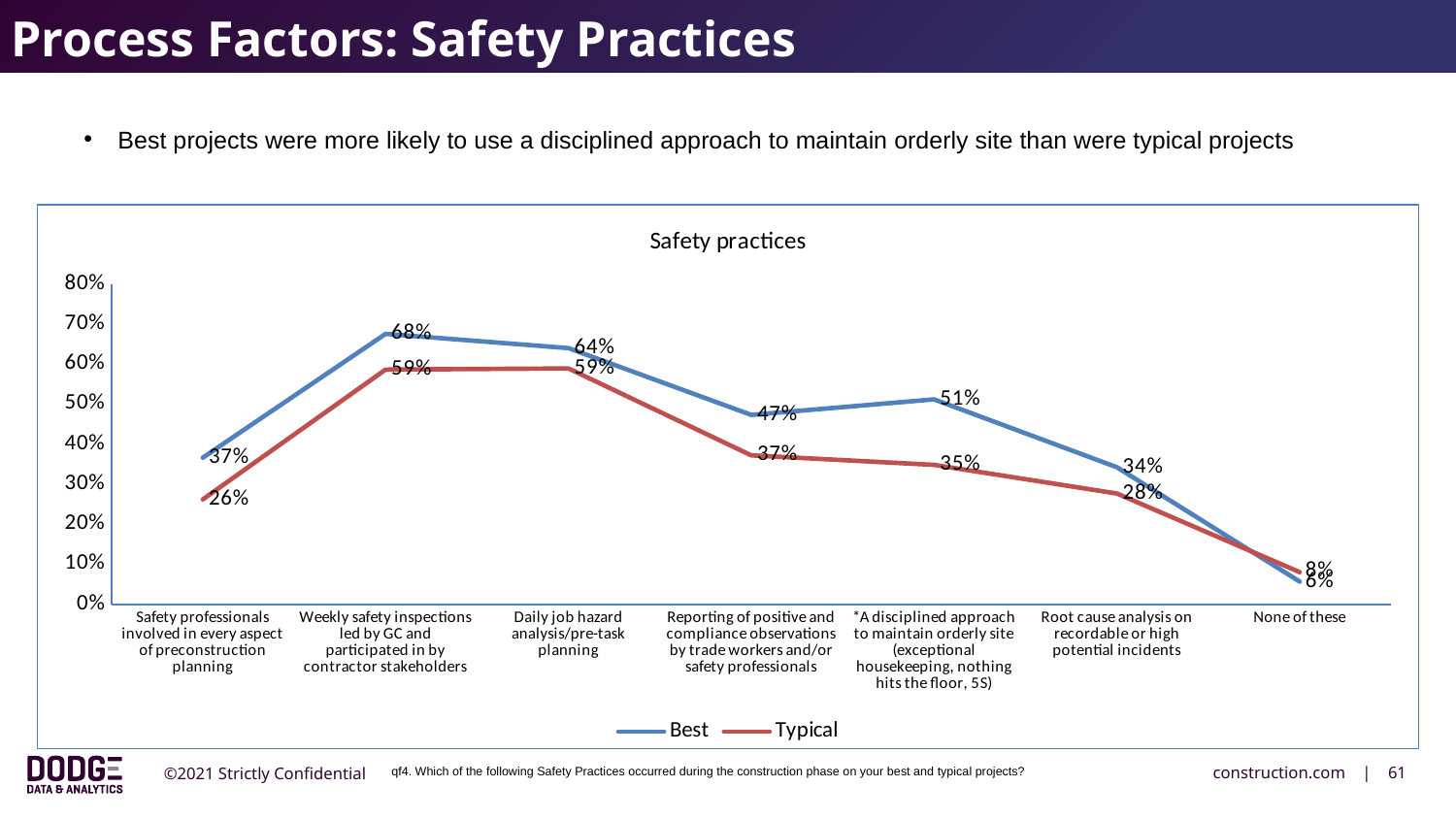
How many series does the legend list? 2 What is the title of the chart? Safety practices What is the Best value for 'Root cause analysis on recordable or high potential incidents'? 34% What is the Typical value for '*A disciplined approach to maintain orderly site'? 35% What is the Best value for 'Weekly safety inspections led by GC and participated in by contractor stakeholders'? 68% Which category has the highest Best value? Weekly safety inspections led by GC and participated in by contractor stakeholders Which category has the lowest Typical value? None of these What is the Typical value for 'Safety professionals involved in every aspect of preconstruction planning'? 26% What type of chart is shown on the slide? Line chart How many categories are plotted along the x axis? 7 What is the difference between the Best and Typical values for '*A disciplined approach to maintain orderly site'? 16% For 'None of these', which series has the larger value, Best or Typical? Typical